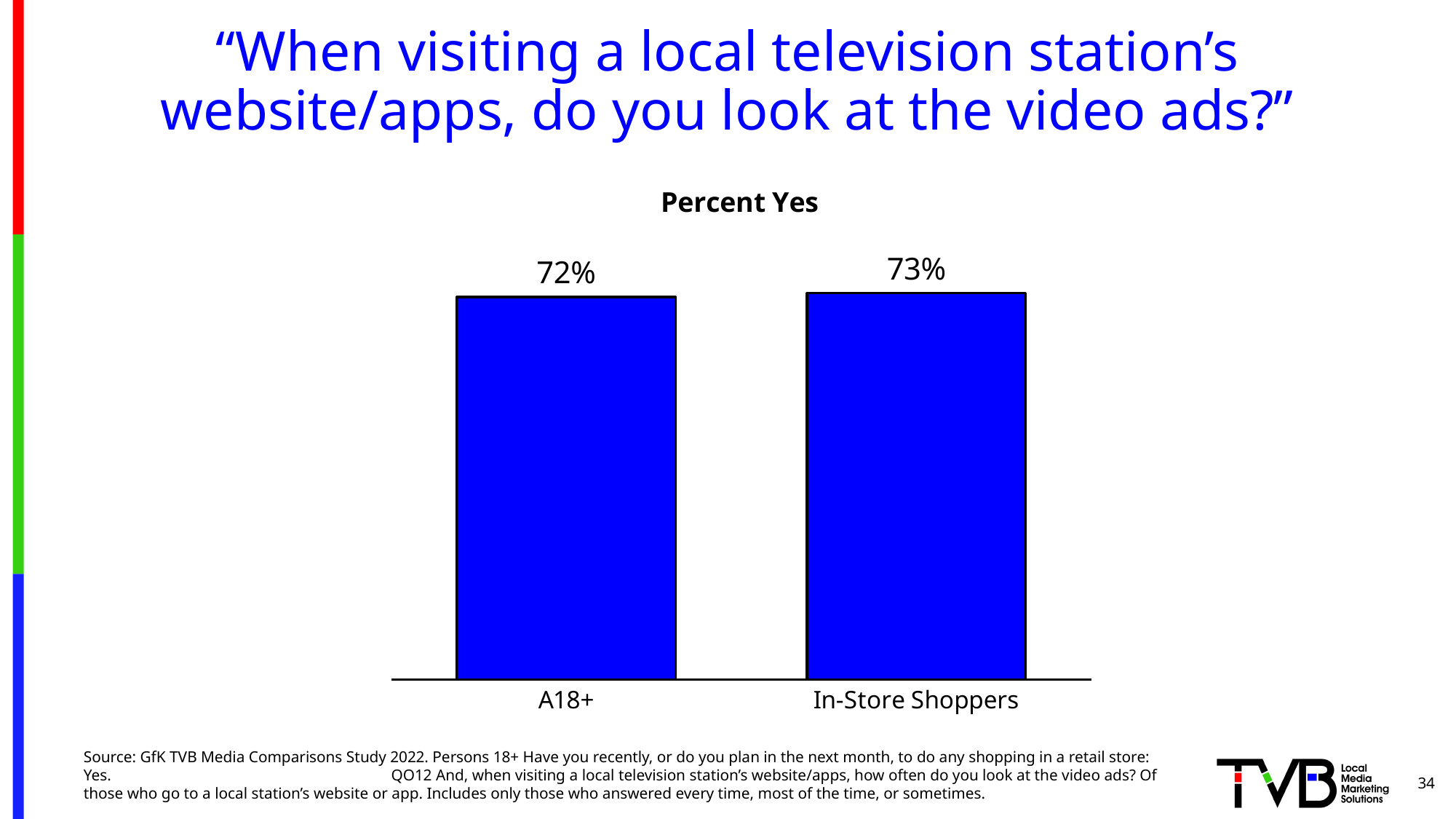
What is the value for A18+? 72% Which category has the higher Percent Yes value? In-Store Shoppers What colour are the bars in the chart? blue What kind of chart is shown on the slide? bar chart How many categories are shown in the chart? 2 What is the value for In-Store Shoppers? 73% What is the difference between the In-Store Shoppers value and the A18+ value? 1% What is the title of the chart? Percent Yes Is the value for In-Store Shoppers larger or smaller than the value for A18+? larger Which category has the lower Percent Yes value? A18+